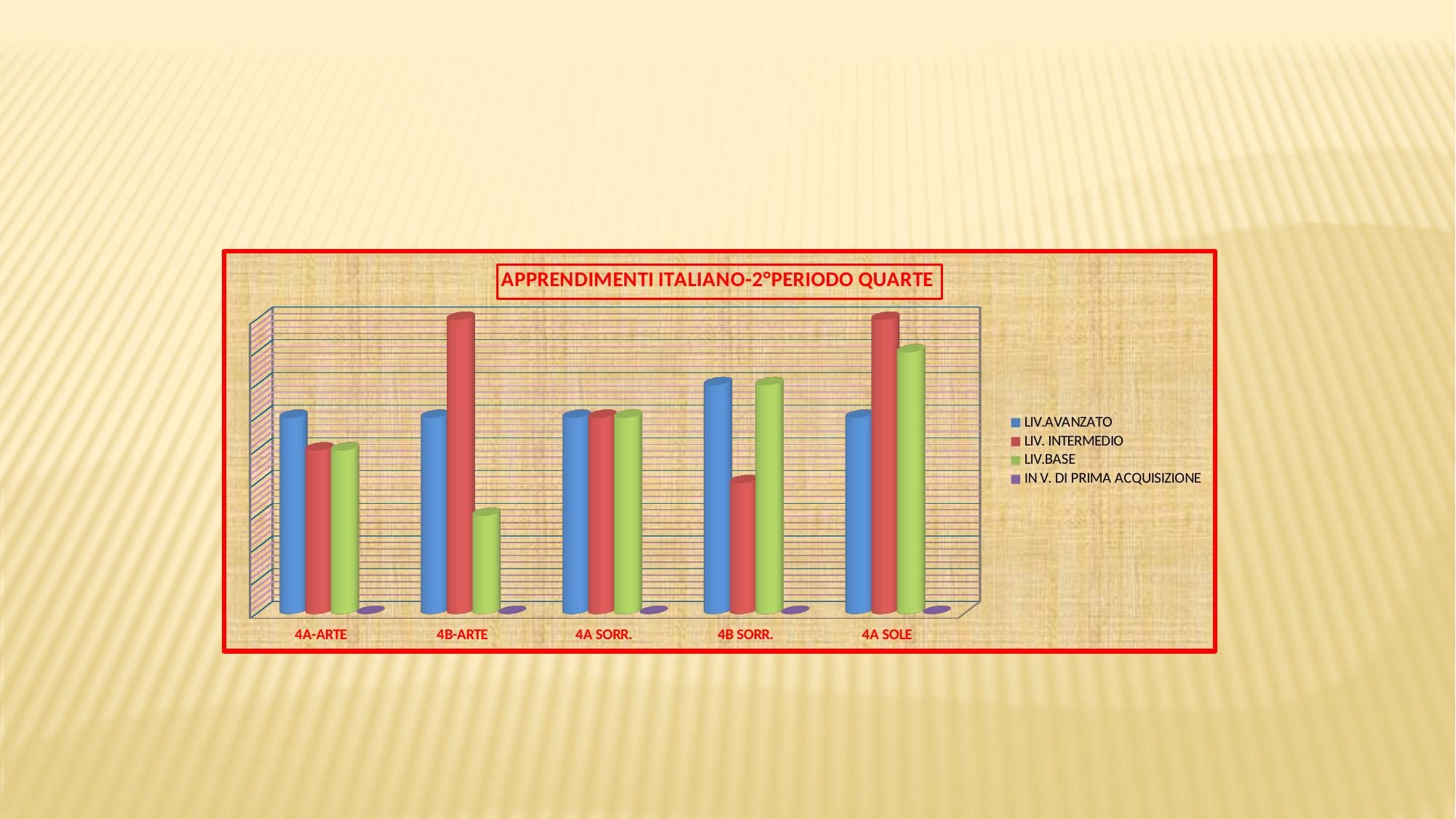
What is the title of the chart? APPRENDIMENTI ITALIANO-2°PERIODO QUARTE How many series does the chart's legend list? 4 For 4A-ARTE, which series has the highest bar? LIV.AVANZATO Which category has the highest LIV.AVANZATO bar? 4B SORR. For 4B-ARTE, which series has the highest bar? LIV. INTERMEDIO What kind of chart is shown on the slide? Bar chart For 4B SORR., which series has the lowest bar? IN V. DI PRIMA ACQUISIZIONE Which category has the lowest LIV.BASE bar? 4B-ARTE Is the LIV. INTERMEDIO bar larger for 4B-ARTE or for 4A-ARTE? 4B-ARTE Which colour represents LIV.BASE in the chart? Green How many categories are shown on the x axis of the chart? 5